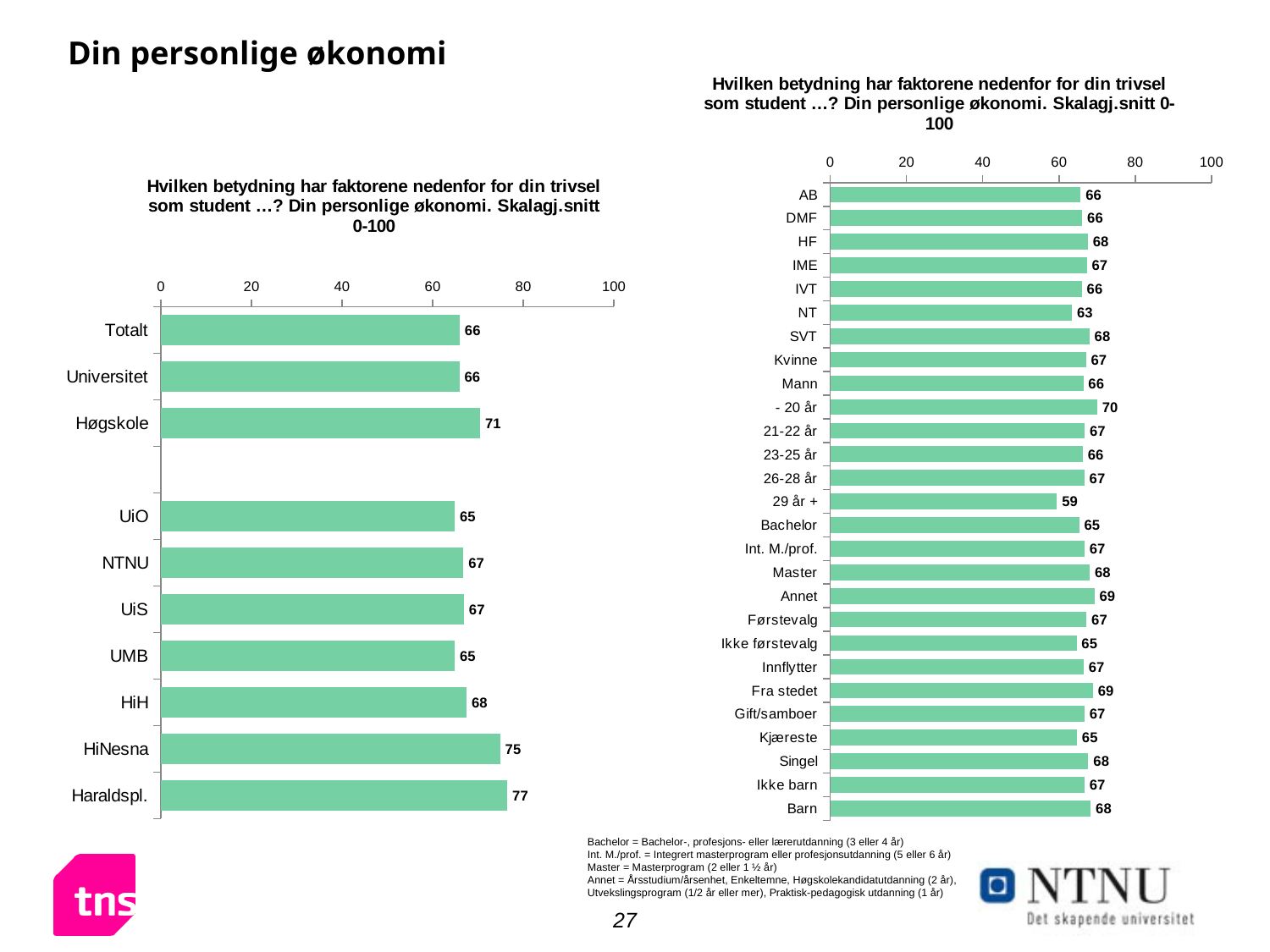
On the left chart, which category has the highest value? Haraldspl. On the left chart, what is the value for Haraldspl.? 77 How many categories are plotted on the right chart? 27 On the right chart, what is the difference between - 20 år and 29 år +? 11 On the right chart, what is the value for 29 år +? 59 On the left chart, what is the difference between HiNesna and UiO? 10 On the left chart, which is larger, the value for HiH or the value for UMB? HiH On the right chart, which category has the lowest value? 29 år + On the right chart, what is the value for NT? 63 What kind of chart is the left chart? Bar chart On the left chart, what is the value for Høgskole? 71 How many categories are plotted on the left chart? 10